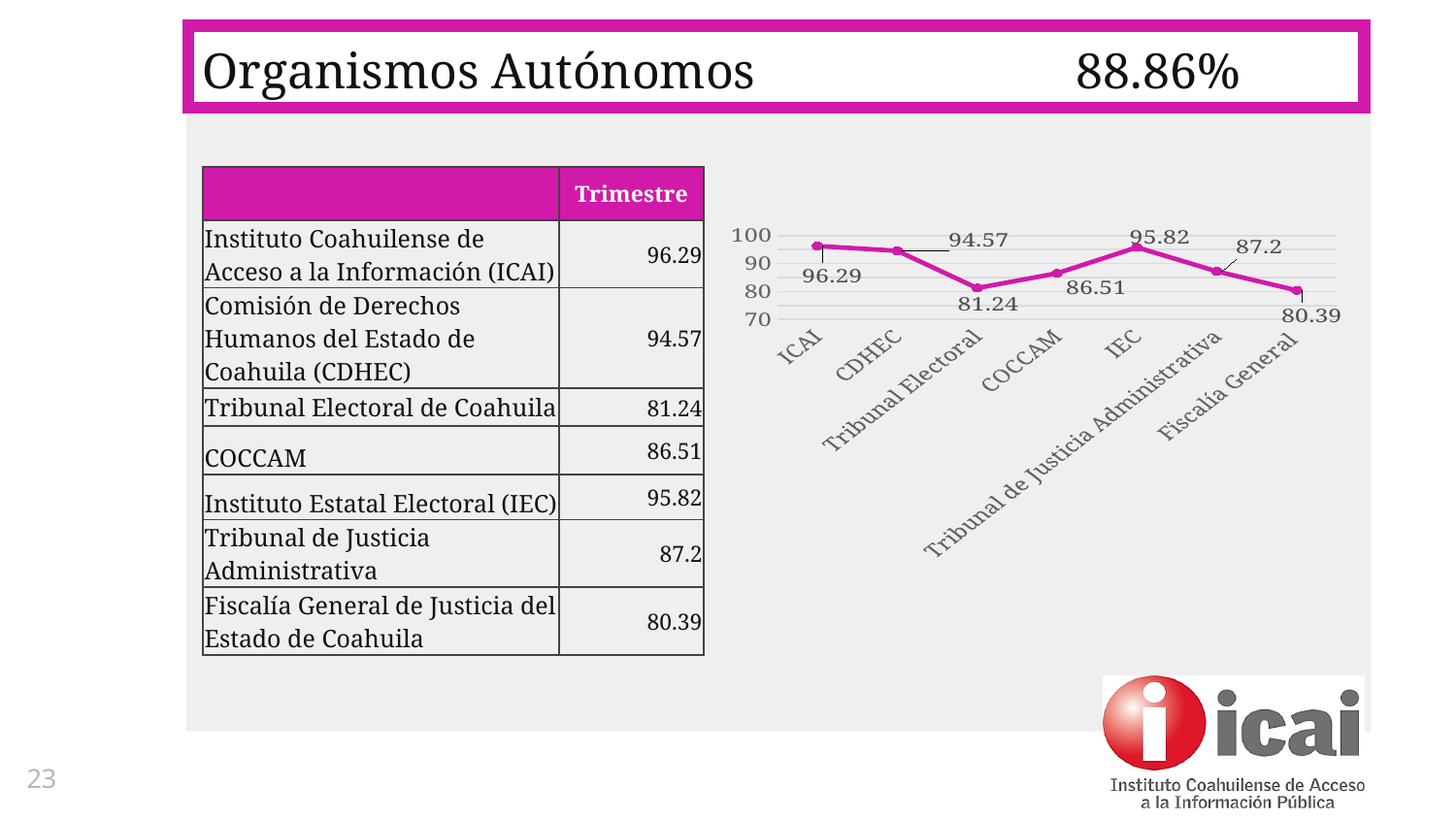
How many categories are plotted along the x axis of the line chart? 7 Which category has the lowest value in the line chart? Fiscalía General What is the difference between the values for IEC and Tribunal Electoral in the line chart? 14.58 What type of chart is shown on the slide? line chart What is the value plotted for ICAI in the line chart? 96.29 What is the difference between the values for ICAI and Fiscalía General in the line chart? 15.9 Does the line rise or fall between IEC and Fiscalía General in the line chart? fall What is the value plotted for Tribunal de Justicia Administrativa in the line chart? 87.2 Which is larger in the line chart, the value for CDHEC or the value for COCCAM? CDHEC What is the value plotted for Fiscalía General in the line chart? 80.39 What is the value plotted for COCCAM in the line chart? 86.51 Which category has the highest value in the line chart? ICAI